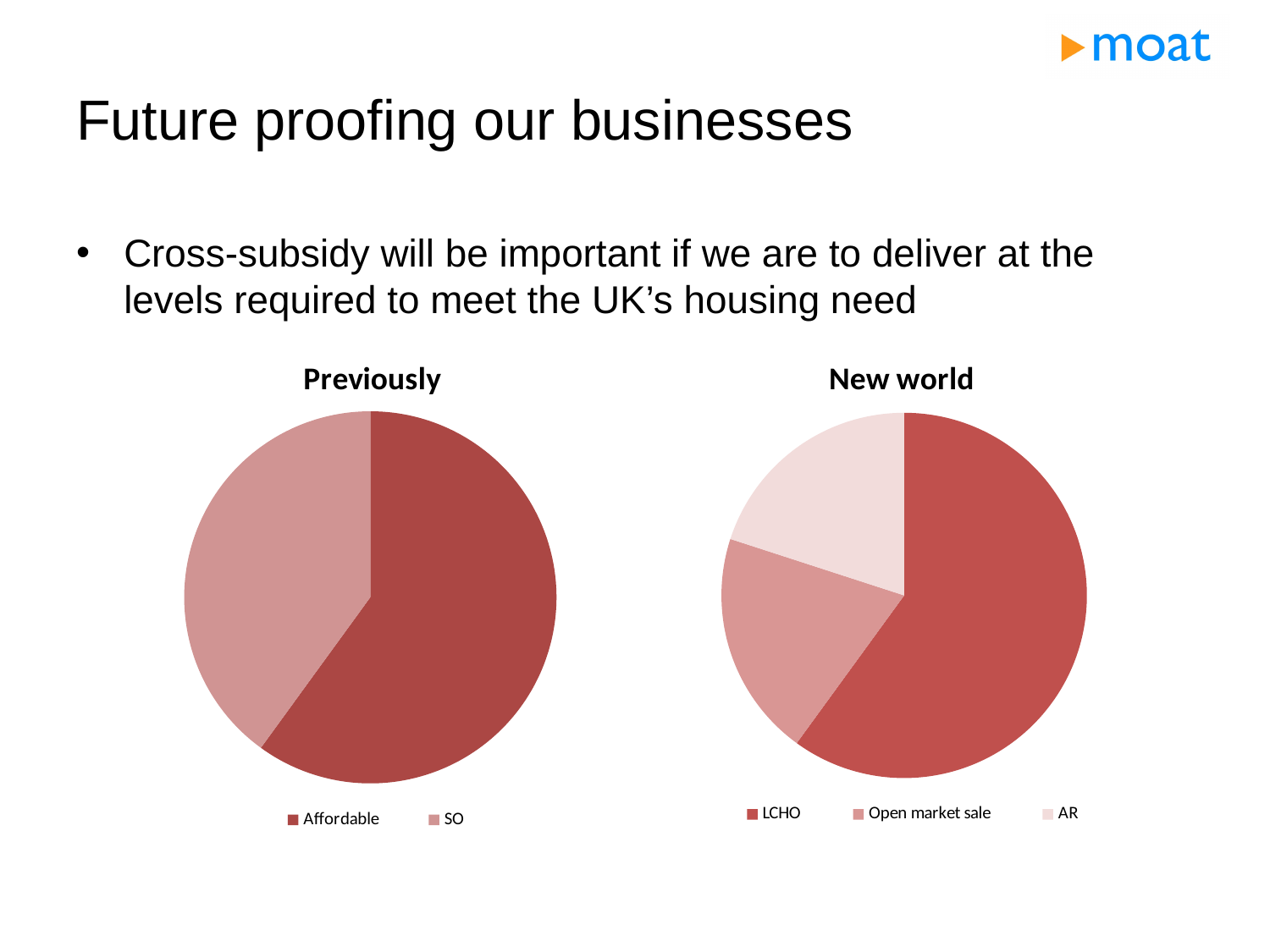
What are the legend entries of the "New world" chart? LCHO, Open market sale, AR In the "Previously" chart, which is larger, Affordable or SO? Affordable What kind of chart is the "New world" chart? pie chart In the "New world" chart, which is larger, Open market sale or LCHO? LCHO How many slices does the "New world" pie chart have? 3 What kind of chart is the "Previously" chart? pie chart In the "New world" chart, which is larger, LCHO or AR? LCHO In the "New world" chart, which category has the largest slice? LCHO In the "Previously" chart, which category has the smallest slice? SO In the "Previously" chart, which category has the largest slice? Affordable How many slices does the "Previously" pie chart have? 2 What is the title of the pie chart on the left? Previously